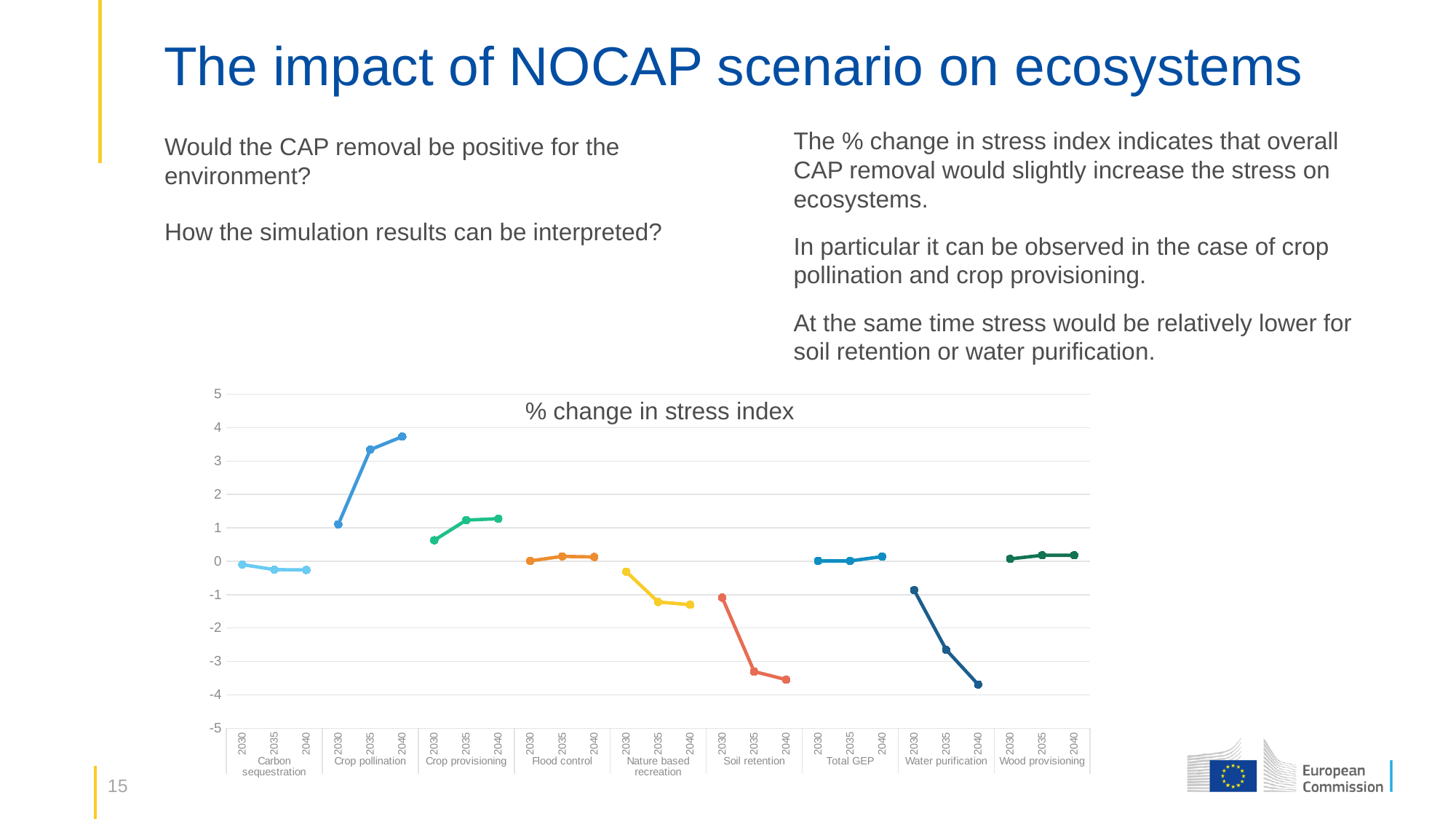
What kind of chart is shown on the slide? line chart Is the value for Crop pollination in 2040 greater or less than 3? greater Which is larger in 2040: the value for Crop pollination or the value for Crop provisioning? Crop pollination Does the value for Water purification rise or fall from 2030 to 2040? fall What is the title of the chart? % change in stress index Is the value for Water purification in 2040 greater or less than -3? less Which category reaches the highest % change in stress index in the chart? Crop pollination How many years are plotted for each category in the chart? 3 How many ecosystem service categories are shown along the x axis of the chart? 9 Is the value for Nature based recreation in 2035 greater or less than -1? less